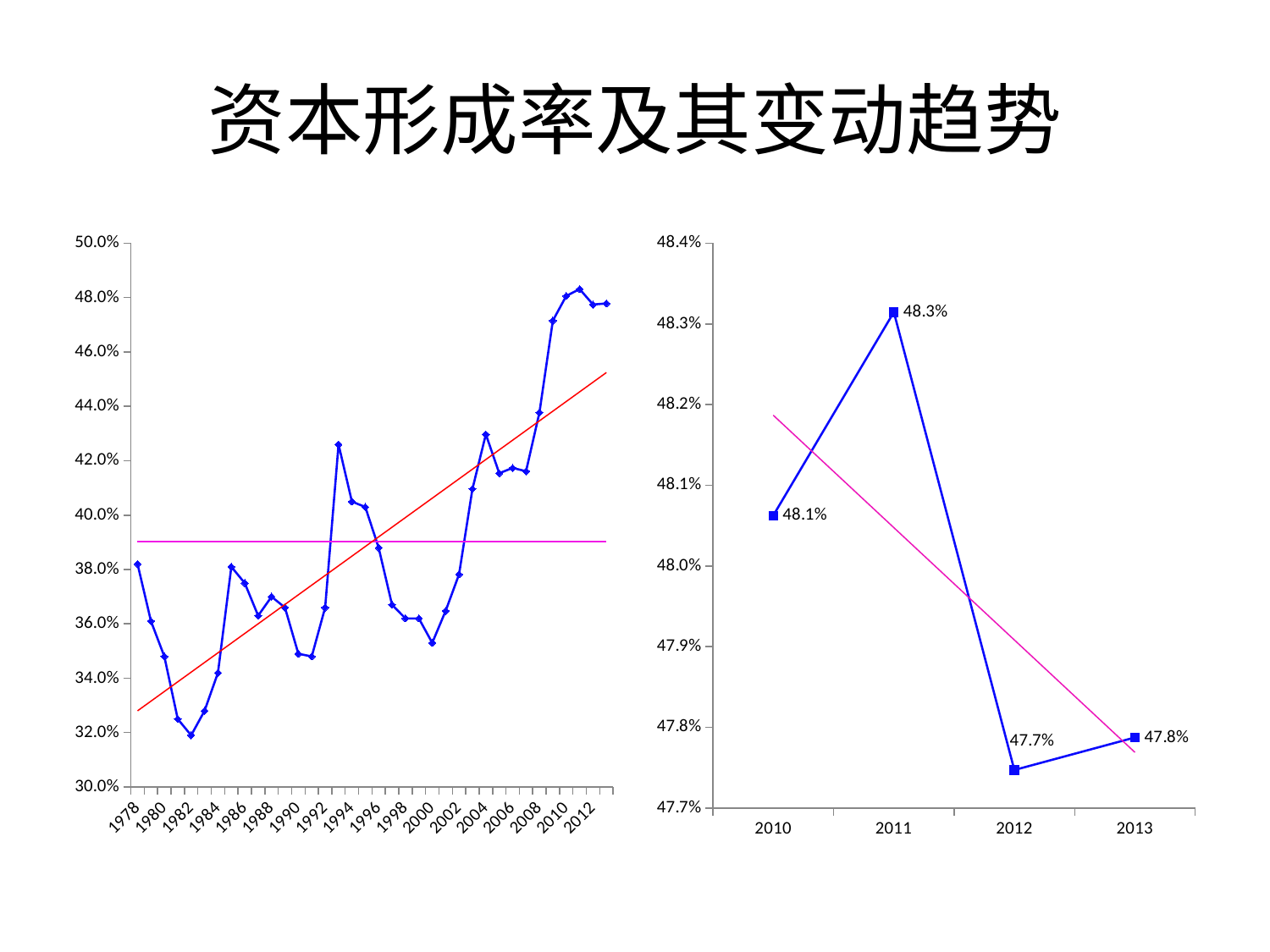
In the right chart (2010–2013), which year has the highest value? 2011 In the right chart (2010–2013), what is the value for 2012? 47.7% In the left chart (1978–2013), is the value for 1978 greater or less than 36.0%? greater What kind of chart is the left chart (1978–2013)? Line chart In the right chart (2010–2013), what is the value for 2010? 48.1% In the right chart (2010–2013), which is larger, the value for 2010 or the value for 2013? 2010 In the right chart (2010–2013), what is the value for 2011? 48.3% In the right chart (2010–2013), what is the difference between the 2011 value and the 2012 value? 0.6% In the left chart (1978–2013), is the value for 2000 greater or less than 38.0%? less In the left chart (1978–2013), which year has the lowest value? 1982 In the right chart (2010–2013), which year has the lowest value? 2012 In the right chart (2010–2013), how many data points are plotted on the blue line? 4